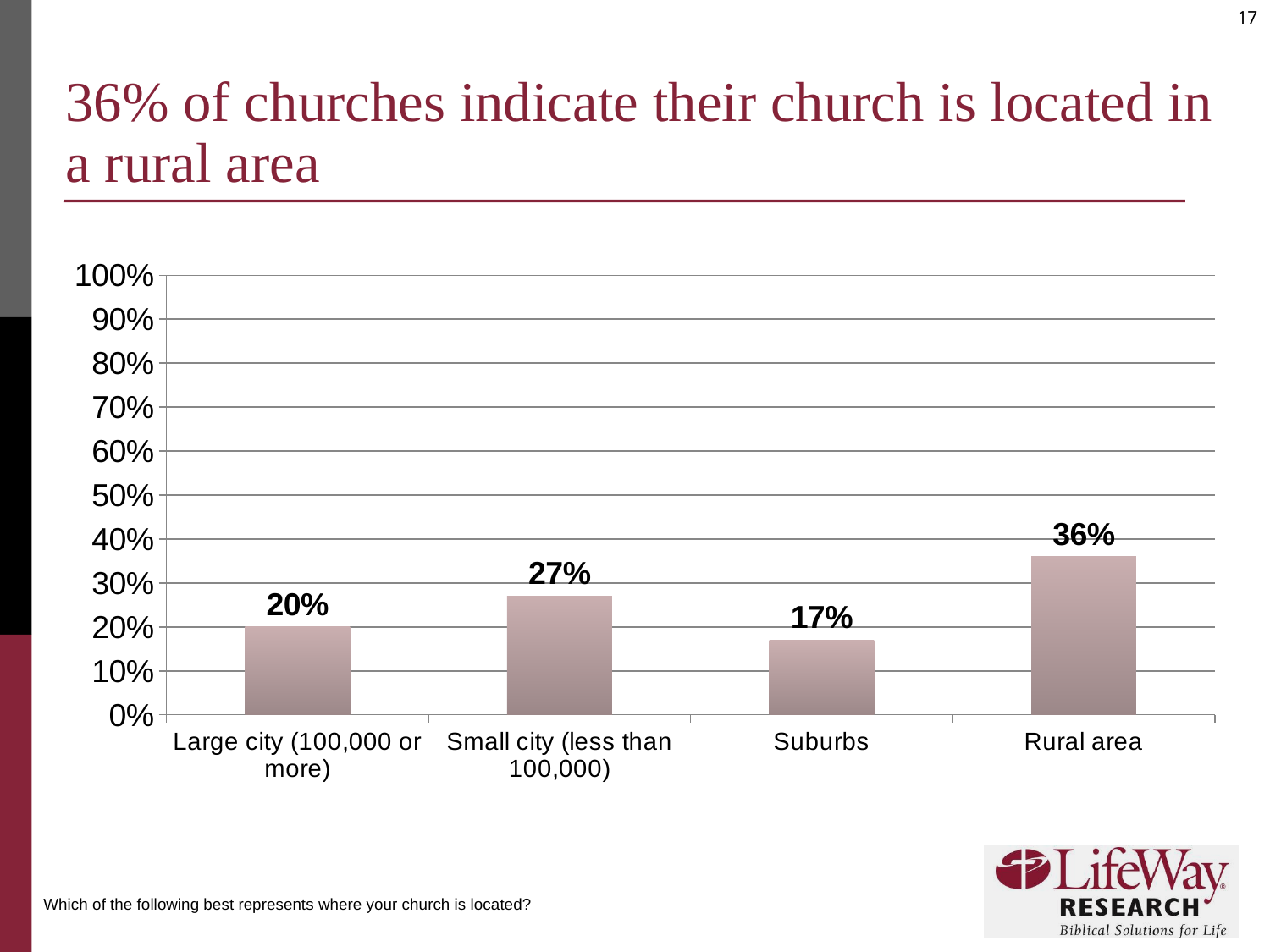
What is the value for Large city (100,000 or more)? 20% What is the value for Suburbs? 17% Which category has the lowest value? Suburbs Which category has the highest value? Rural area How many categories are shown on the chart? 4 What is the value for Small city (less than 100,000)? 27% What percentage of churches are located in a rural area? 36% Which is larger, the value for Large city (100,000 or more) or the value for Suburbs? Large city (100,000 or more) What is the difference between the Small city (less than 100,000) value and the Large city (100,000 or more) value? 7% Is the value for Rural area greater or less than 50%? less What kind of chart is shown on the slide? bar chart What is the difference between the Rural area value and the Suburbs value? 19%